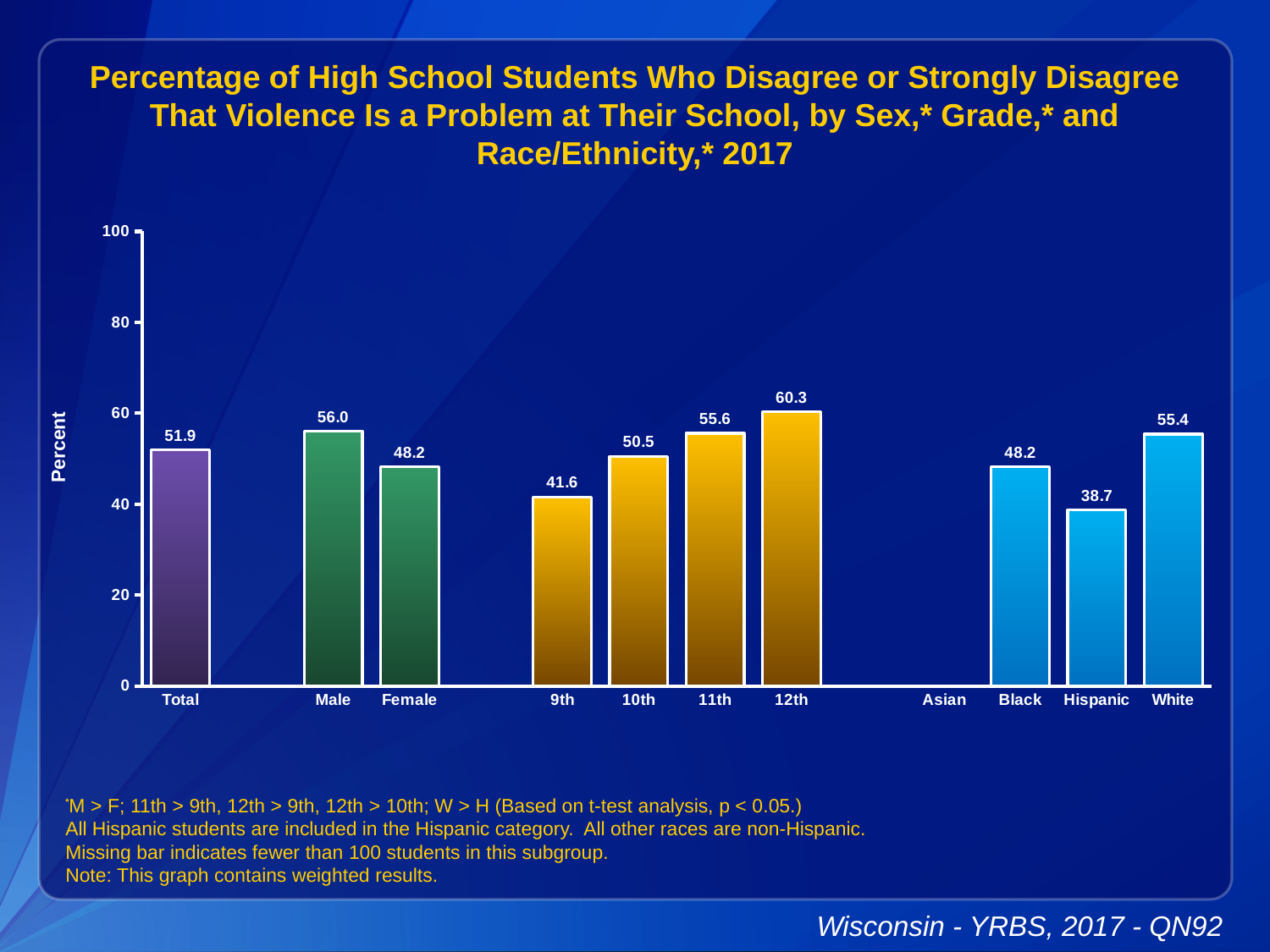
What is the value for Male? 56.0 How many categories have a bar plotted? 10 What is the difference between the Male and Female values? 7.8 Which category has the lowest value among those with a bar? Hispanic What kind of chart is shown? bar chart Which race/ethnicity category has no bar shown? Asian What is the value for Total? 51.9 Is the value for 9th grade greater or less than 40? greater What is the value for Hispanic? 38.7 Which grade has the highest value? 12th Which is larger, the value for 11th grade or the value for 10th grade? 11th Do the values rise or fall from 9th grade to 12th grade? rise